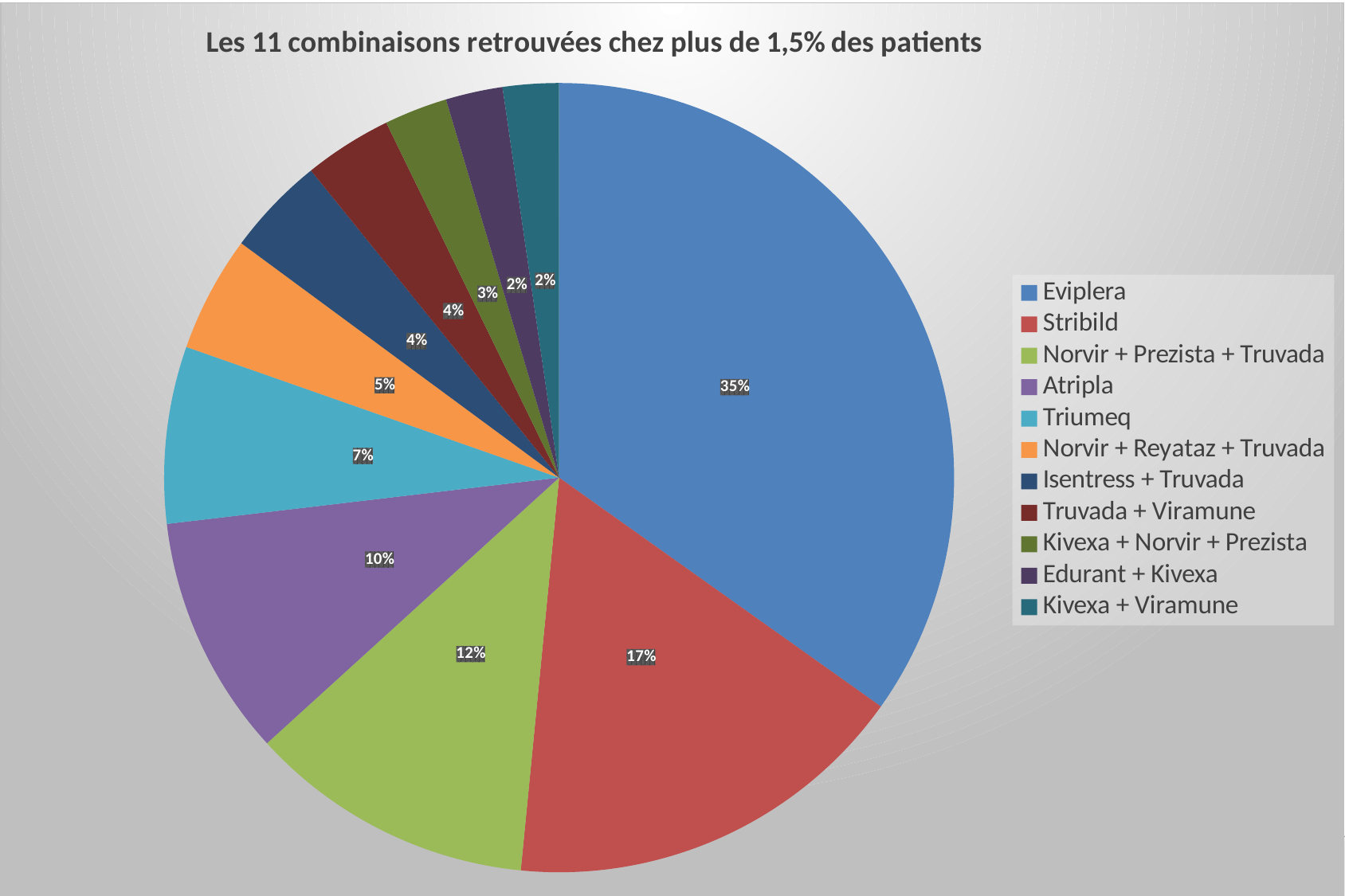
Which combination has the largest share of the pie? Eviplera What share of the pie does Eviplera represent? 35% What is the value shown for Stribild? 17% How many slices does the pie chart have? 11 What is the value shown for Norvir + Prezista + Truvada? 12% What is the title of the chart? Les 11 combinaisons retrouvées chez plus de 1,5% des patients What is the value shown for Atripla? 10% What is the difference between the shares of Eviplera and Stribild? 18% Which has a larger share, Atripla or Triumeq? Atripla What is the value shown for Triumeq? 7% What type of chart is shown on the slide? pie chart What is the value shown for Norvir + Reyataz + Truvada? 5%